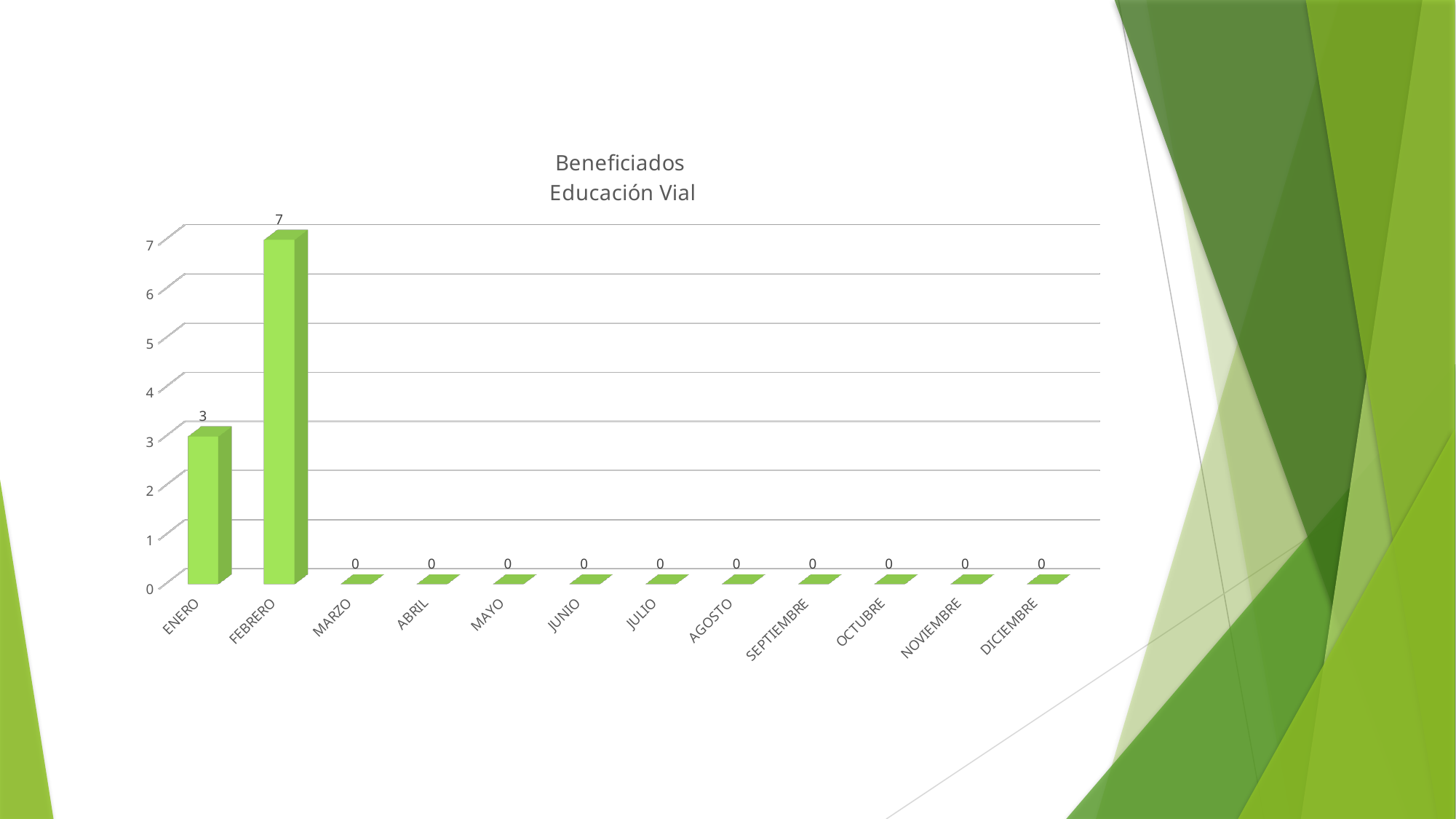
Which is larger, the value for ENERO or the value for FEBRERO? FEBRERO What is the value for ENERO? 3 What is the title of the chart? Beneficiados Educación Vial How many months are shown on the x axis? 12 What is the difference between the values for FEBRERO and ENERO? 4 How many months have a value of 0? 10 Which month has the highest value? FEBRERO What kind of chart is shown on the slide? bar chart What is the highest value shown on the vertical axis? 7 What is the value for DICIEMBRE? 0 What is the value for MARZO? 0 What is the value for FEBRERO? 7